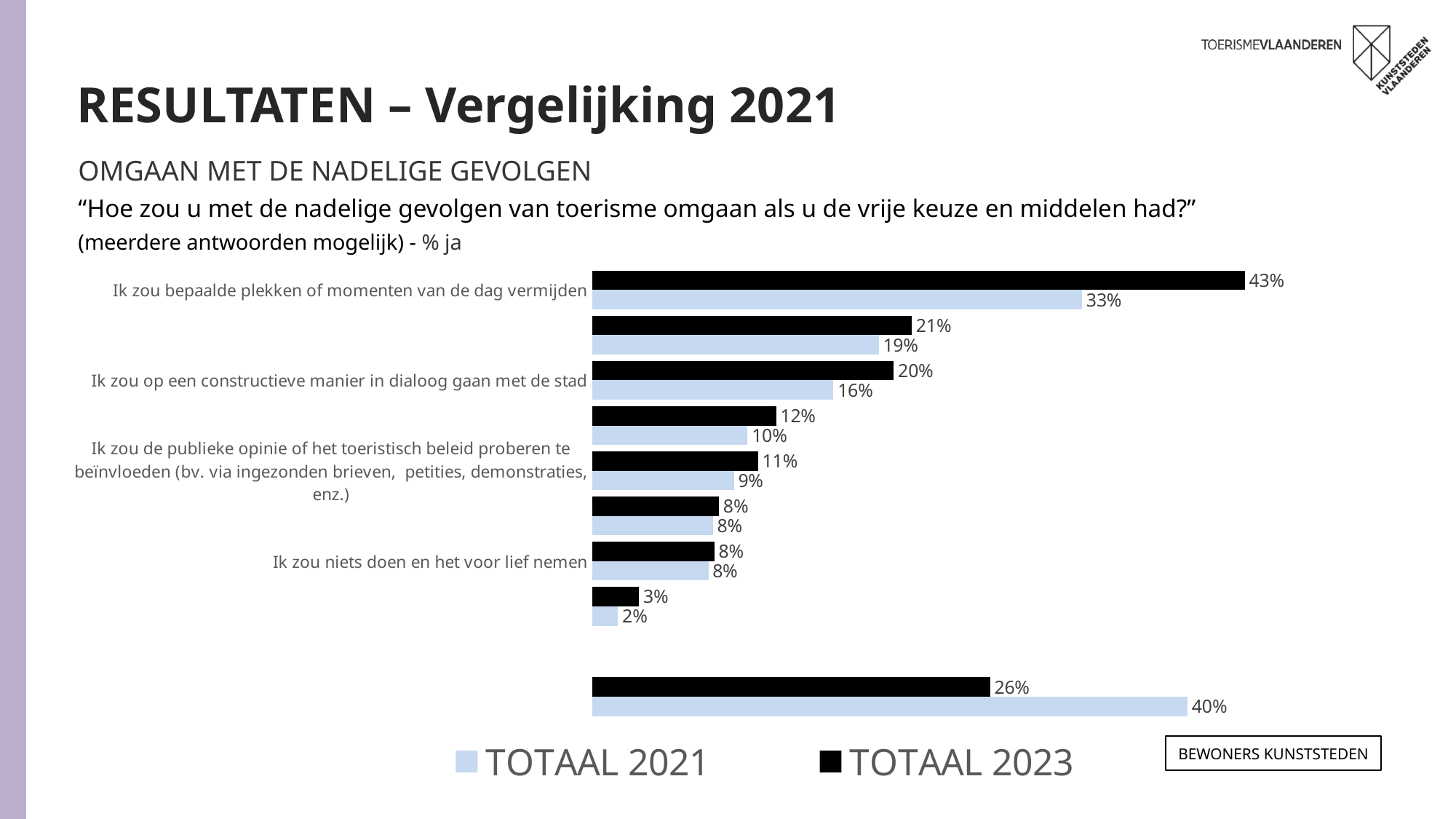
What kind of chart is shown on the slide? Bar chart What is the TOTAAL 2023 value for "Ik zou op een constructieve manier in dialoog gaan met de stad"? 20% Which category has the highest TOTAAL 2023 value? Ik zou bepaalde plekken of momenten van de dag vermijden What is the TOTAAL 2023 value for "Ik zou bepaalde plekken of momenten van de dag vermijden"? 43% How many series does the legend list? 2 For "Ik zou op een constructieve manier in dialoog gaan met de stad", which series has the larger value, TOTAAL 2021 or TOTAAL 2023? TOTAAL 2023 What is the TOTAAL 2023 value for "Ik zou niets doen en het voor lief nemen"? 8% By how many percentage points does the TOTAAL 2023 value exceed the TOTAAL 2021 value for "Ik zou bepaalde plekken of momenten van de dag vermijden"? 10 percentage points What colour represents the TOTAAL 2023 series in the chart? Black What is the TOTAAL 2021 value for "Ik zou bepaalde plekken of momenten van de dag vermijden"? 33% How many categories (pairs of bars) are plotted in the chart? 9 What is the TOTAAL 2021 value for "Ik zou op een constructieve manier in dialoog gaan met de stad"? 16%